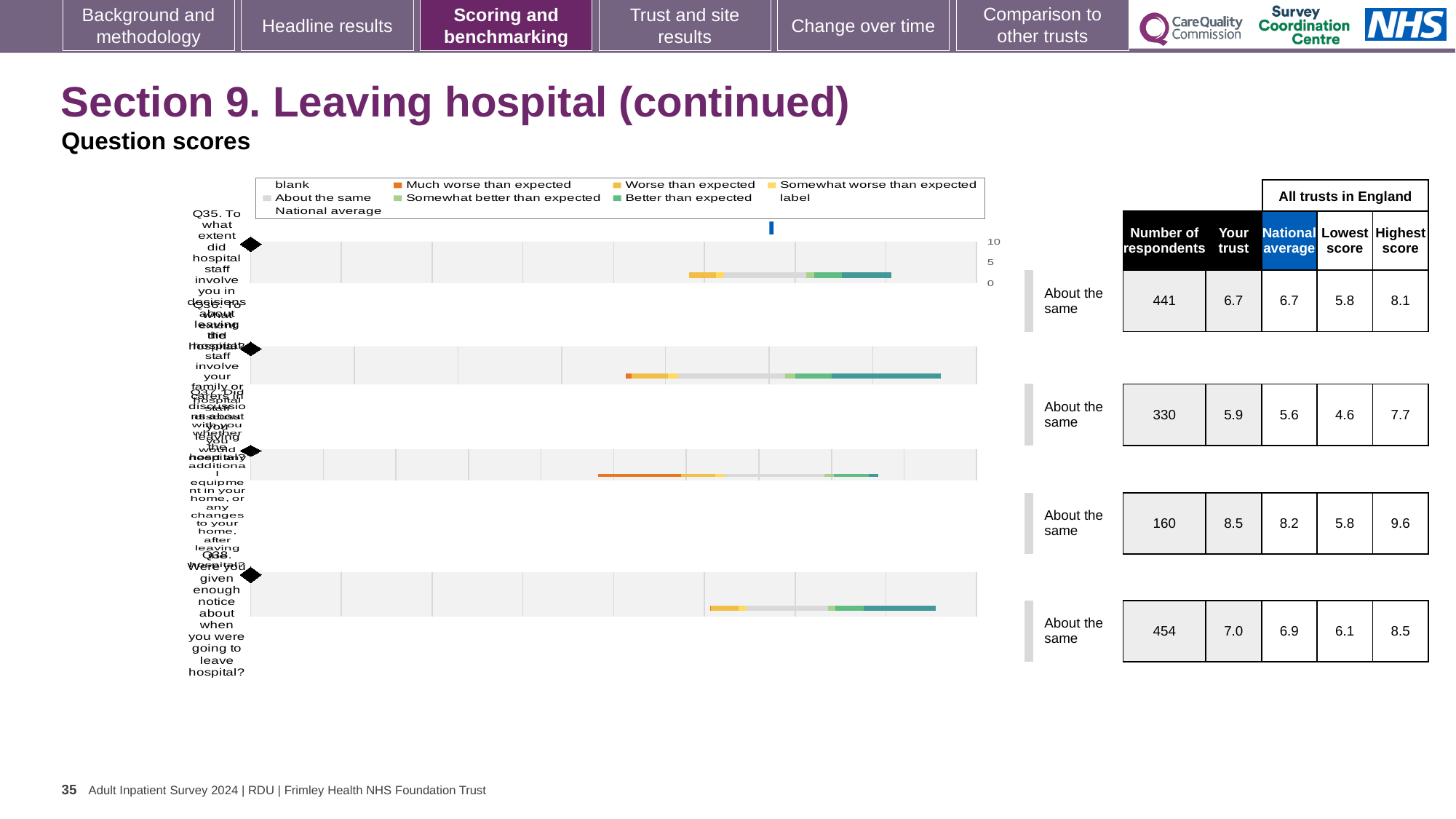
What kind of chart is shown on the slide? bar chart What colour represents 'Much worse than expected' in the chart legend? orange For the second row (Q36), which is larger: the 'Your trust' score or the national average? Your trust (5.9) How many respondents are listed for Q38 (given enough notice about when you were going to leave hospital)? 454 How many question rows (categories) does the chart show? 4 What is the highest score across all trusts in England for the third row (Q37)? 9.6 Which row has the highest 'Your trust' score? the third row (Q37), 8.5 What benchmark category is shown for Q35? About the same How many entries does the chart's legend list? 9 What is the 'Your trust' score for Q35 (involving you in decisions about leaving hospital)? 6.7 For the third row (Q37), what is the difference between the 'Your trust' score and the national average? 0.3 Which row has the lowest number of respondents? the third row (Q37), 160